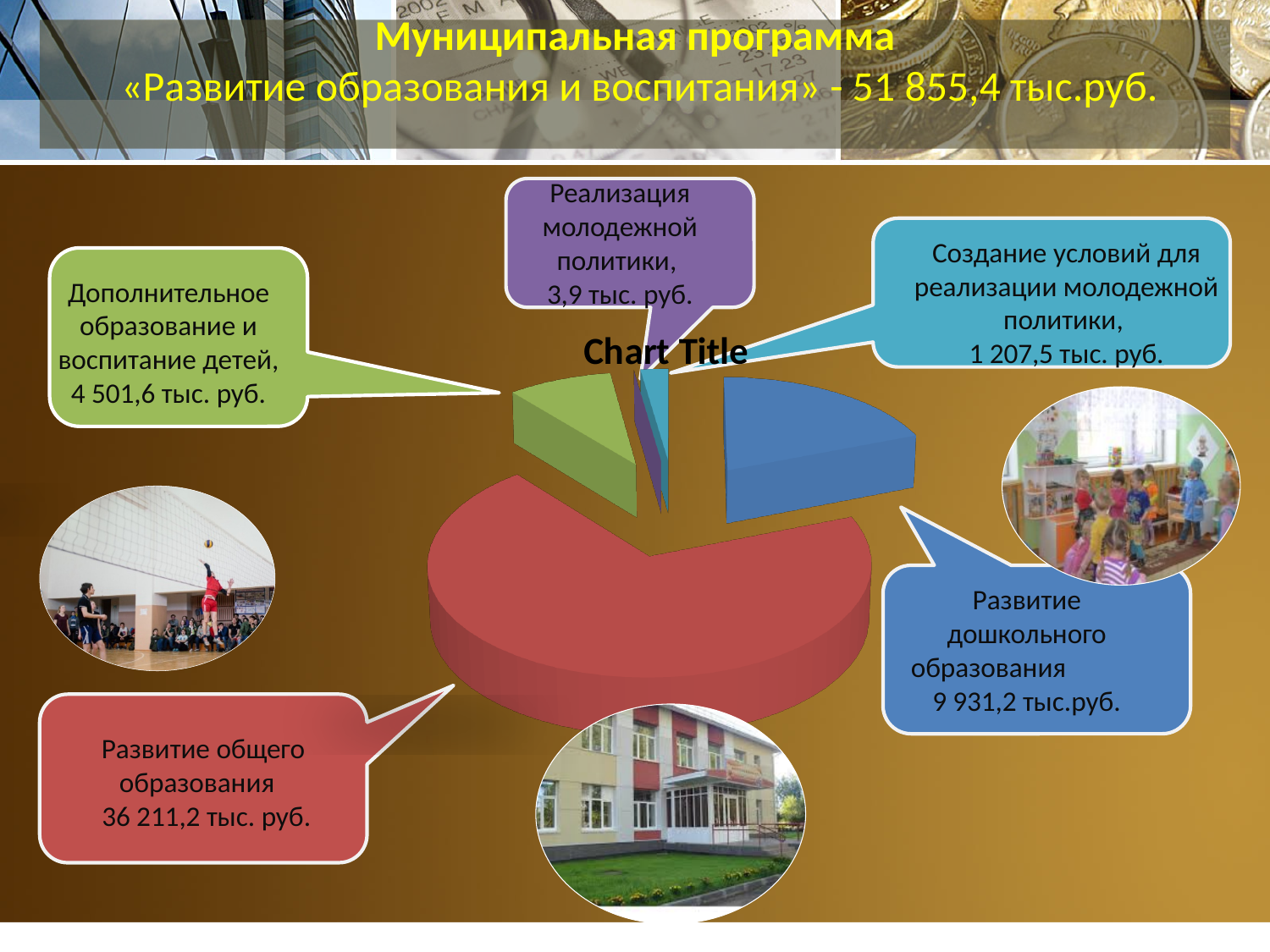
What title is printed above the pie chart? Chart Title What kind of chart is shown on the slide? Pie chart How many slices does the pie chart have? 5 Which is larger: «Дополнительное образование и воспитание детей» or «Создание условий для реализации молодежной политики»? Дополнительное образование и воспитание детей What is the value for «Развитие общего образования»? 36 211,2 тыс. руб. Which category has the largest slice of the pie? Развитие общего образования What is the difference between «Развитие общего образования» and «Развитие дошкольного образования»? 26 280,0 тыс. руб. Which category has the smallest slice of the pie? Реализация молодежной политики What is the value for «Развитие дошкольного образования»? 9 931,2 тыс.руб. What is the value for «Реализация молодежной политики»? 3,9 тыс. руб. What is the value for «Создание условий для реализации молодежной политики»? 1 207,5 тыс. руб. What is the value for «Дополнительное образование и воспитание детей»? 4 501,6 тыс. руб.